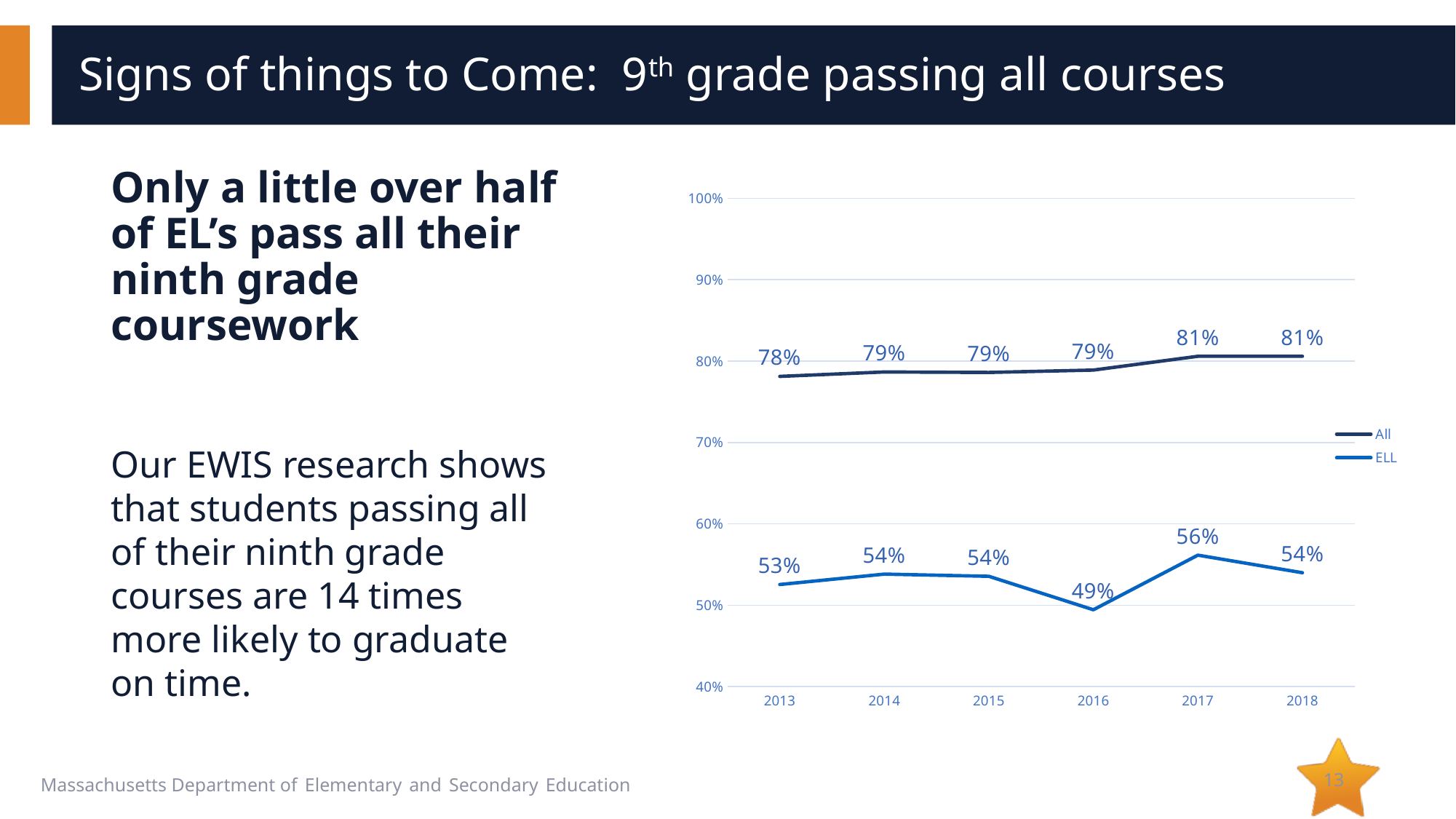
In which year is the ELL value highest? 2017 What are the two series named in the legend? All and ELL How many years are shown on the x axis? 6 How many series does the legend list? 2 What is the value for ELL in 2016? 49% What is the value for All in 2013? 78% Does the All series rise or fall from 2013 to 2018? Rise Which series has the larger value in 2015, All or ELL? All What is the value for ELL in 2017? 56% In which year is the ELL value lowest? 2016 What kind of chart is shown on the slide? Line chart What is the difference between the All and ELL values in 2018? 27%